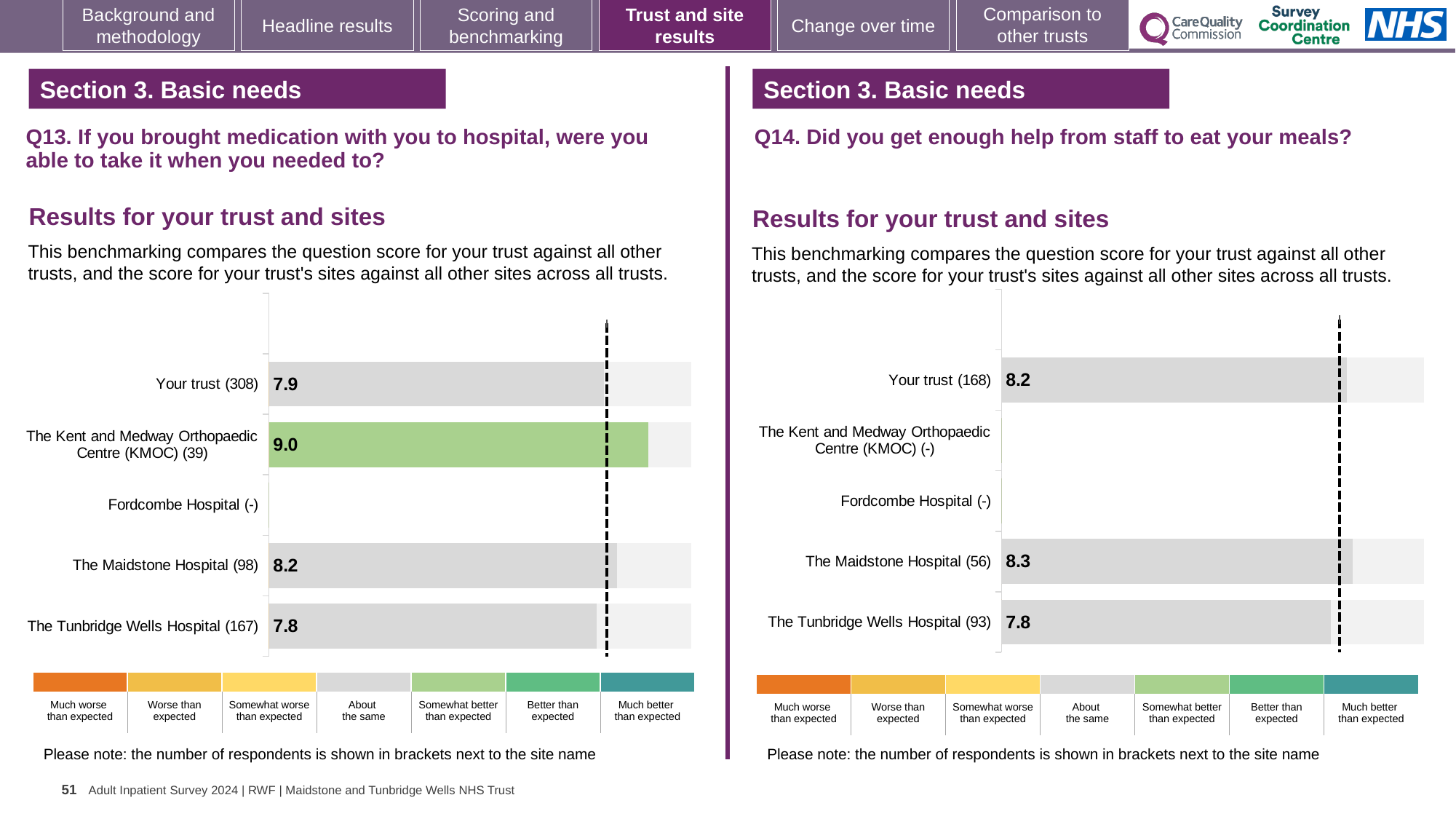
On the Q13 chart, what is the difference between the scores for The Kent and Medway Orthopaedic Centre (KMOC) and The Tunbridge Wells Hospital? 1.2 What kind of chart is used on the Q13 side of the slide? Bar chart On the Q13 chart, which bar is coloured green? The Kent and Medway Orthopaedic Centre (KMOC) On the Q13 chart, what is the score for The Kent and Medway Orthopaedic Centre (KMOC)? 9.0 On the Q14 chart, what is the score for The Tunbridge Wells Hospital? 7.8 On the Q13 chart, what is the score for Your trust? 7.9 On the Q14 chart, what is the difference between the scores for The Maidstone Hospital and The Tunbridge Wells Hospital? 0.5 On the Q13 chart, which site has the highest score? The Kent and Medway Orthopaedic Centre (KMOC) On the Q13 chart, which site has the lowest score? The Tunbridge Wells Hospital On the Q14 chart, which is larger, the score for Your trust or the score for The Tunbridge Wells Hospital? Your trust On the Q14 chart, how many respondents are shown for Your trust? 168 On the Q14 chart, what is the score for The Maidstone Hospital? 8.3